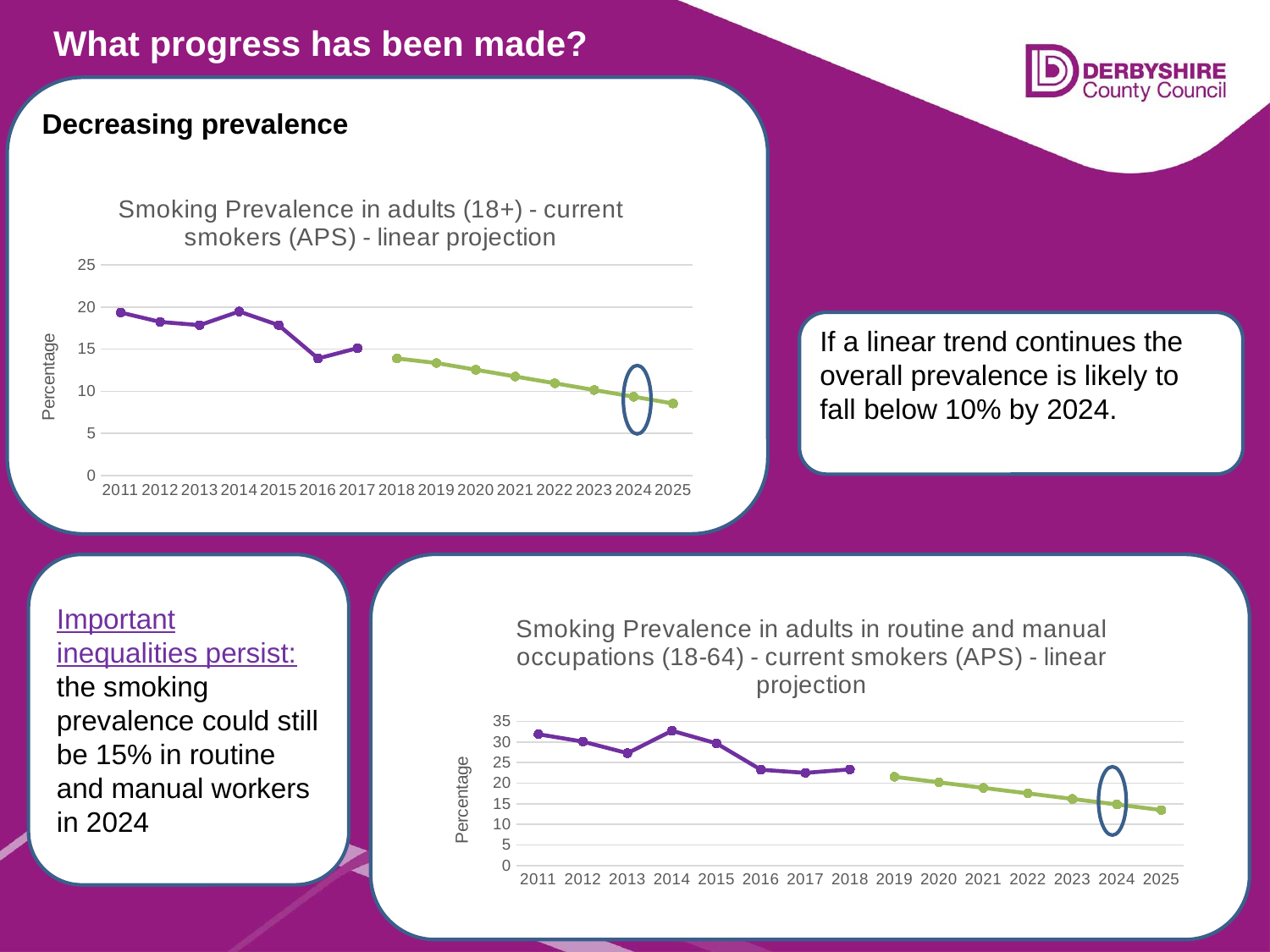
In the bottom chart (routine and manual occupations), is the value for 2011 greater or less than 30? greater In the bottom chart (routine and manual occupations), which is larger, the value for 2013 or the value for 2017? 2013 In the top chart (adults 18+), do the values generally rise or fall from 2011 to 2025? fall In the top chart (adults 18+), is the value for 2025 greater or less than 10? less In the top chart (adults 18+), is the value for 2011 greater or less than 15? greater What kind of chart is the top chart titled 'Smoking Prevalence in adults (18+) - current smokers (APS) - linear projection'? line chart What is the y-axis label on the bottom chart (routine and manual occupations)? Percentage In the top chart (adults 18+), which year has the lowest value? 2025 In the top chart (adults 18+), how many years are shown on the x axis? 15 In the bottom chart (routine and manual occupations), which year has the lowest value? 2025